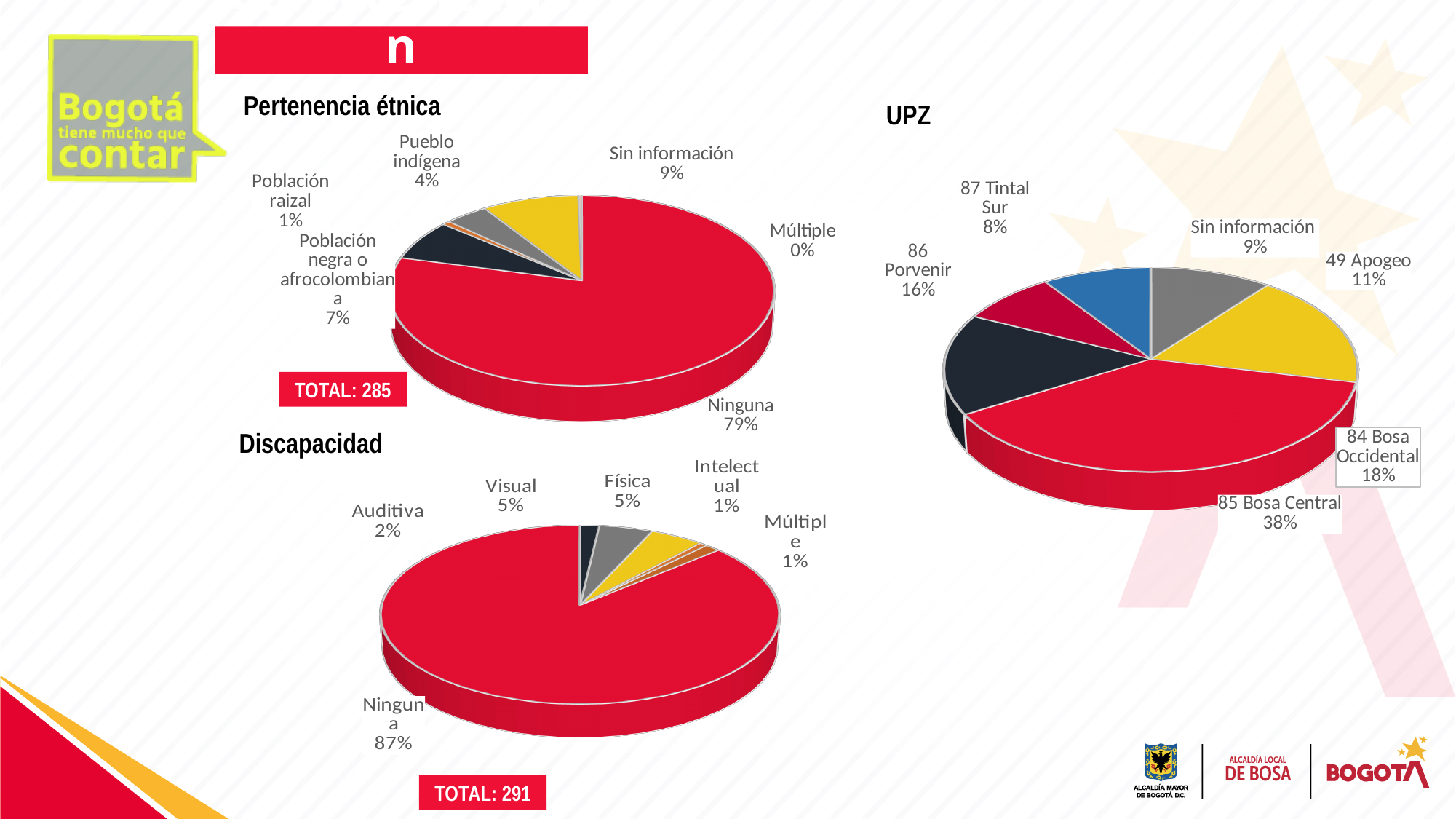
In the 'Discapacidad' chart, which is larger, the share for 'Visual' or the share for 'Auditiva'? Visual In the 'Pertenencia étnica' chart, which category has the smallest share? Múltiple In the 'UPZ' chart, what share is labelled for '86 Porvenir'? 16% In the 'Discapacidad' chart, what share is labelled for 'Ninguna'? 87% In the 'UPZ' chart, which category has the largest share? 85 Bosa Central In the 'Pertenencia étnica' chart, what share is labelled for 'Ninguna'? 79% In the 'Pertenencia étnica' chart, what is the difference between the shares for 'Sin información' and 'Pueblo indígena'? 5% What total is shown for the 'Pertenencia étnica' chart? 285 In the 'UPZ' chart, what is the difference between the shares for '84 Bosa Occidental' and '49 Apogeo'? 7% In the 'Pertenencia étnica' chart, what share is labelled for 'Población negra o afrocolombiana'? 7% What kind of chart is the 'UPZ' chart? Pie chart How many categories are labelled in the 'Discapacidad' chart? 6